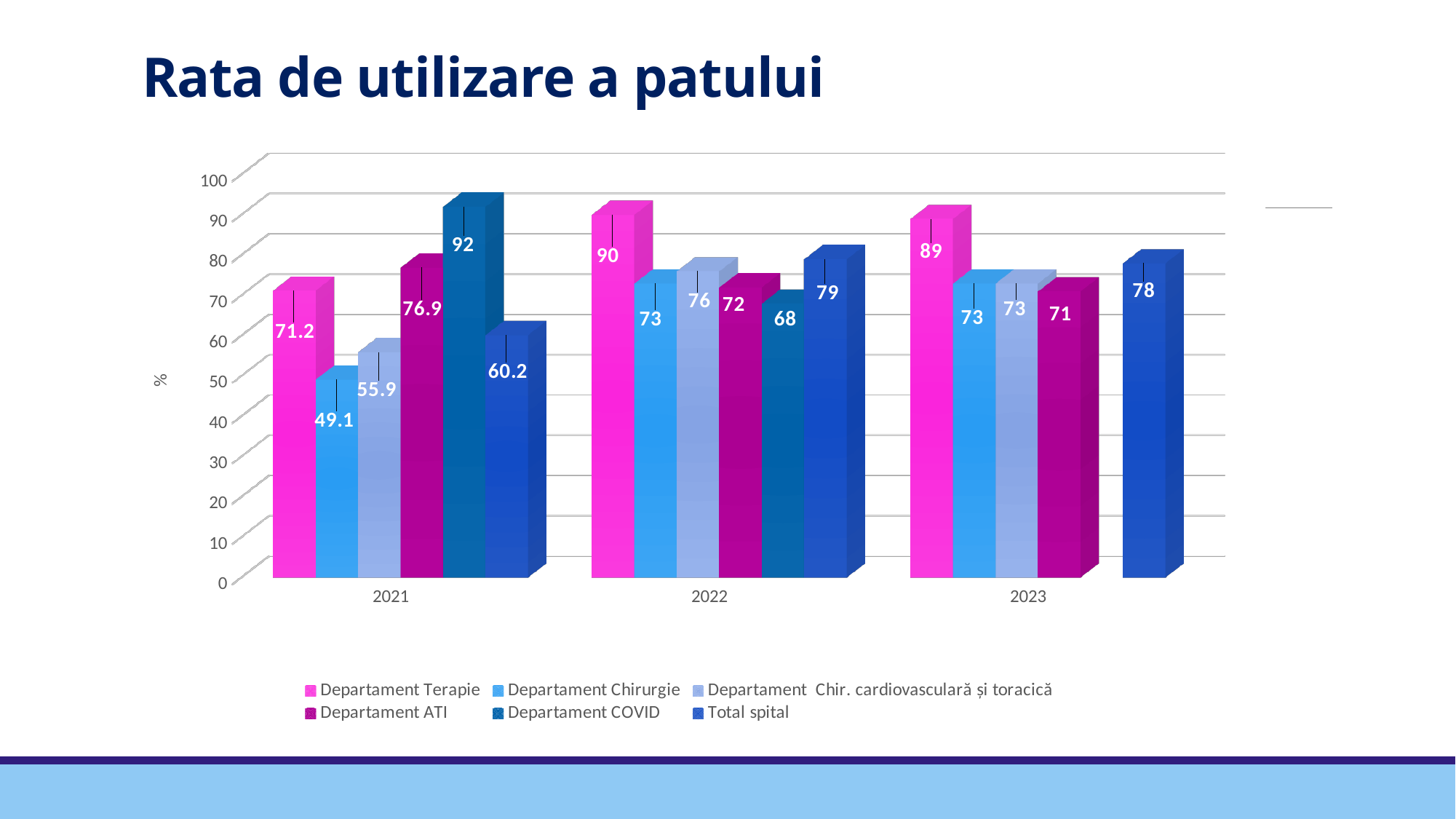
Which department has the highest value in 2021? Departament COVID Which is larger in 2022: Departament Chirurgie or Departament Chir. cardiovasculară și toracică? Departament Chir. cardiovasculară și toracică What is the value for Departament Chirurgie in 2021? 49.1 What is the value for Total spital in 2023? 78 How many series does the legend list? 6 Which department has the lowest value in 2022? Departament COVID What kind of chart is shown on the slide? Bar chart What is the value for Departament COVID in 2021? 92 How many years are shown on the x axis? 3 Does the value for Total spital rise or fall from 2021 to 2022? Rise What is the difference between Departament Terapie and Departament ATI in 2023? 18 What is the value for Departament Terapie in 2022? 90